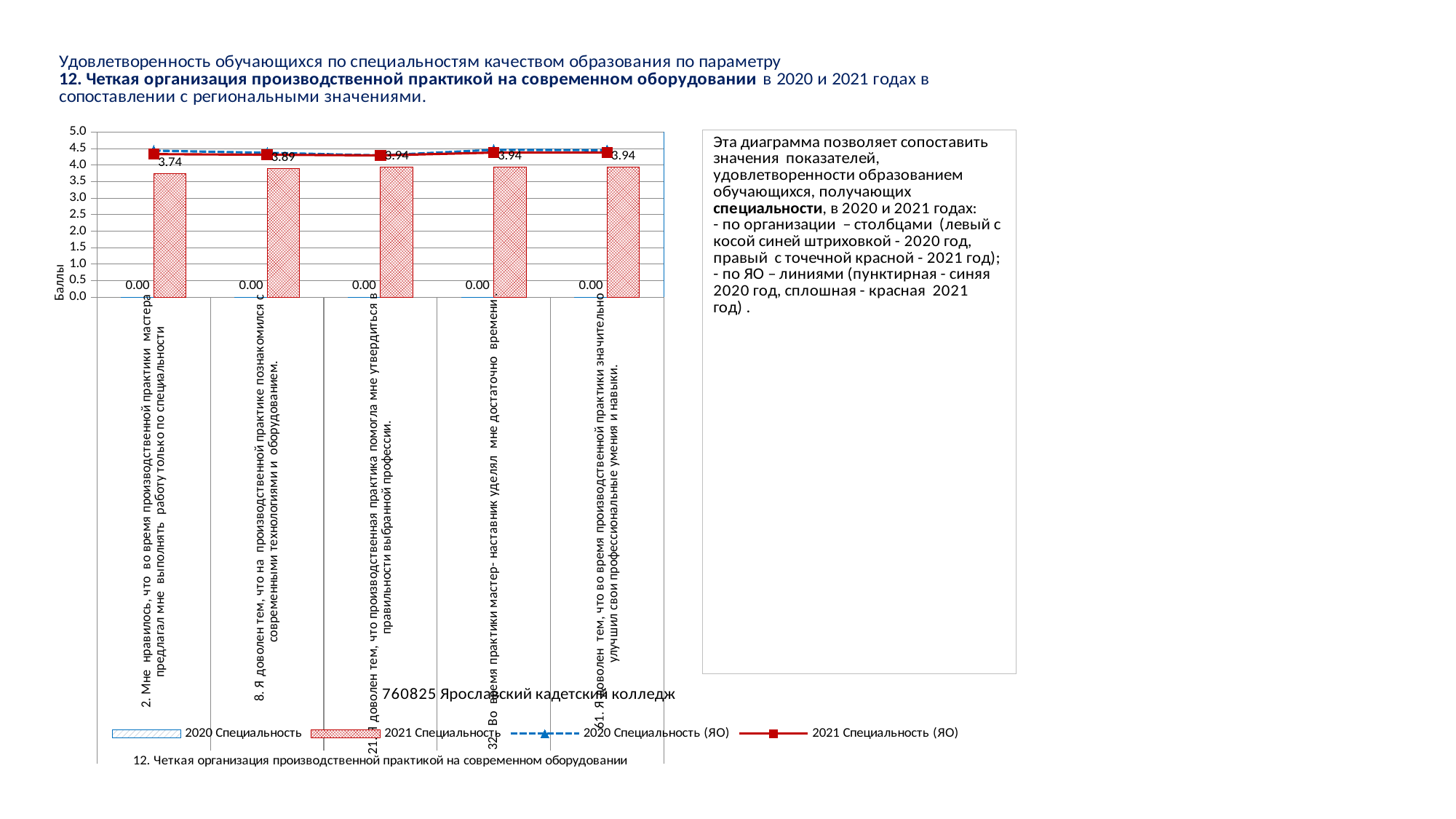
Which is larger for the 2021 Специальность series: the value for question 8 or the value for question 2? Question 8 What is the difference between the 2021 Специальность values for question 8 and question 2? 0.15 Which question has the lowest 2021 Специальность bar? Question 2 What is the value of the 2021 Специальность bar for question 2 ("Мне нравилось, что во время производственной практики мастер предлагал мне выполнять работу только по специальности")? 3.74 What value is labelled for the 2020 Специальность series at question 32? 0.00 What is the title of the vertical axis? Баллы What is the difference between the 2021 Специальность values for question 61 and question 2? 0.20 How many series does the legend list? 4 What kind of chart is used for the 2020 Специальность and 2021 Специальность series? Bar chart What is the value of the 2021 Специальность bar for question 8 ("Я доволен тем, что на производственной практике познакомился с современными технологиями и оборудованием")? 3.89 How many question categories are plotted on the x axis? 5 Is the 2021 Специальность (ЯО) line value at question 2 greater or less than 4.0? greater